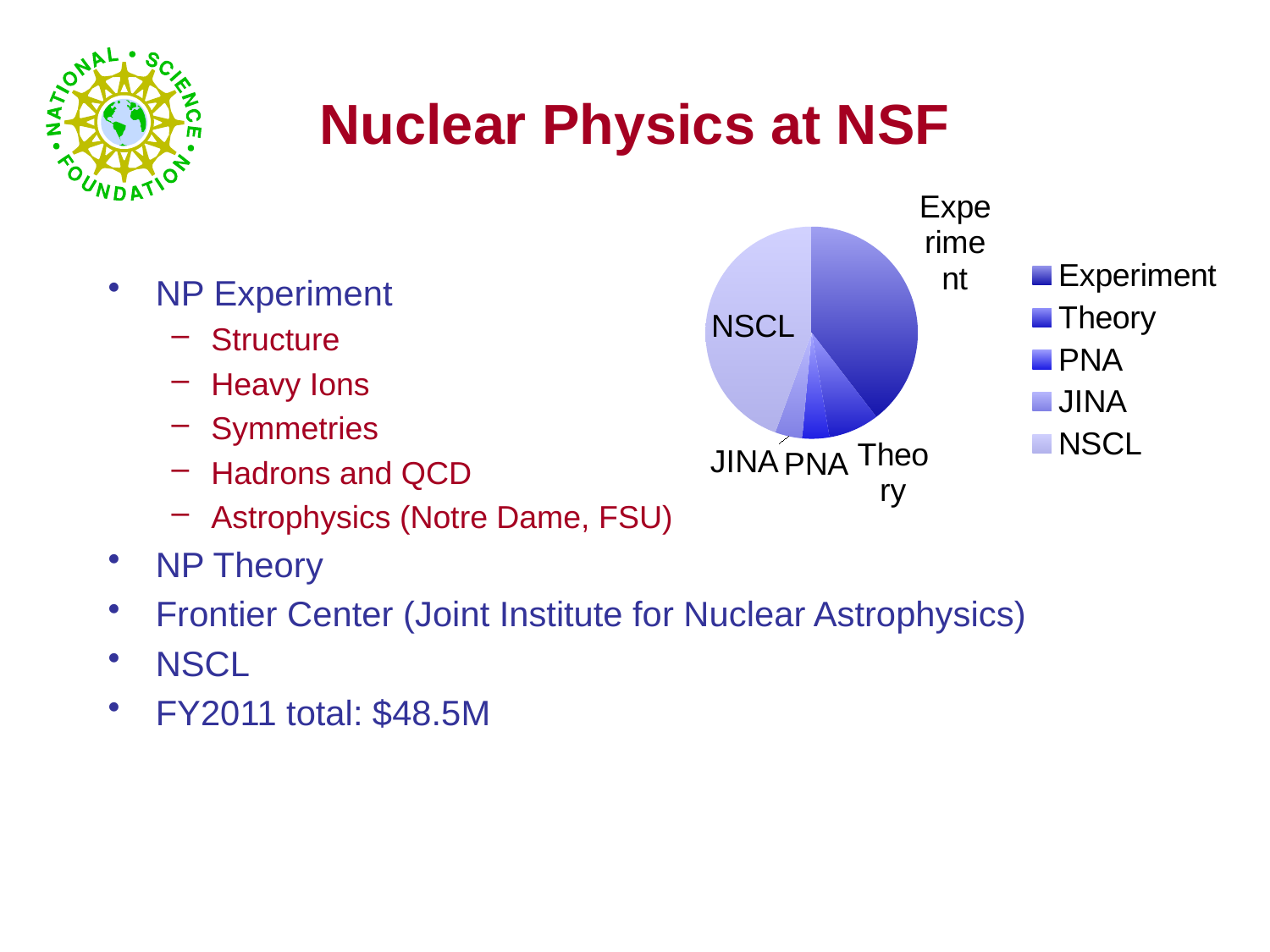
Which legend entry is listed last in the pie chart's legend? NSCL What kind of chart is shown on the slide? pie chart In the pie chart, which slice is larger, Theory or PNA? Theory In the pie chart, which slice is larger, Experiment or Theory? Experiment Which category has the largest slice in the pie chart? NSCL How many entries does the legend of the pie chart list? 5 How many slices does the pie chart have? 5 Which legend entry is listed first in the pie chart's legend? Experiment In the pie chart, which slice is larger, NSCL or JINA? NSCL